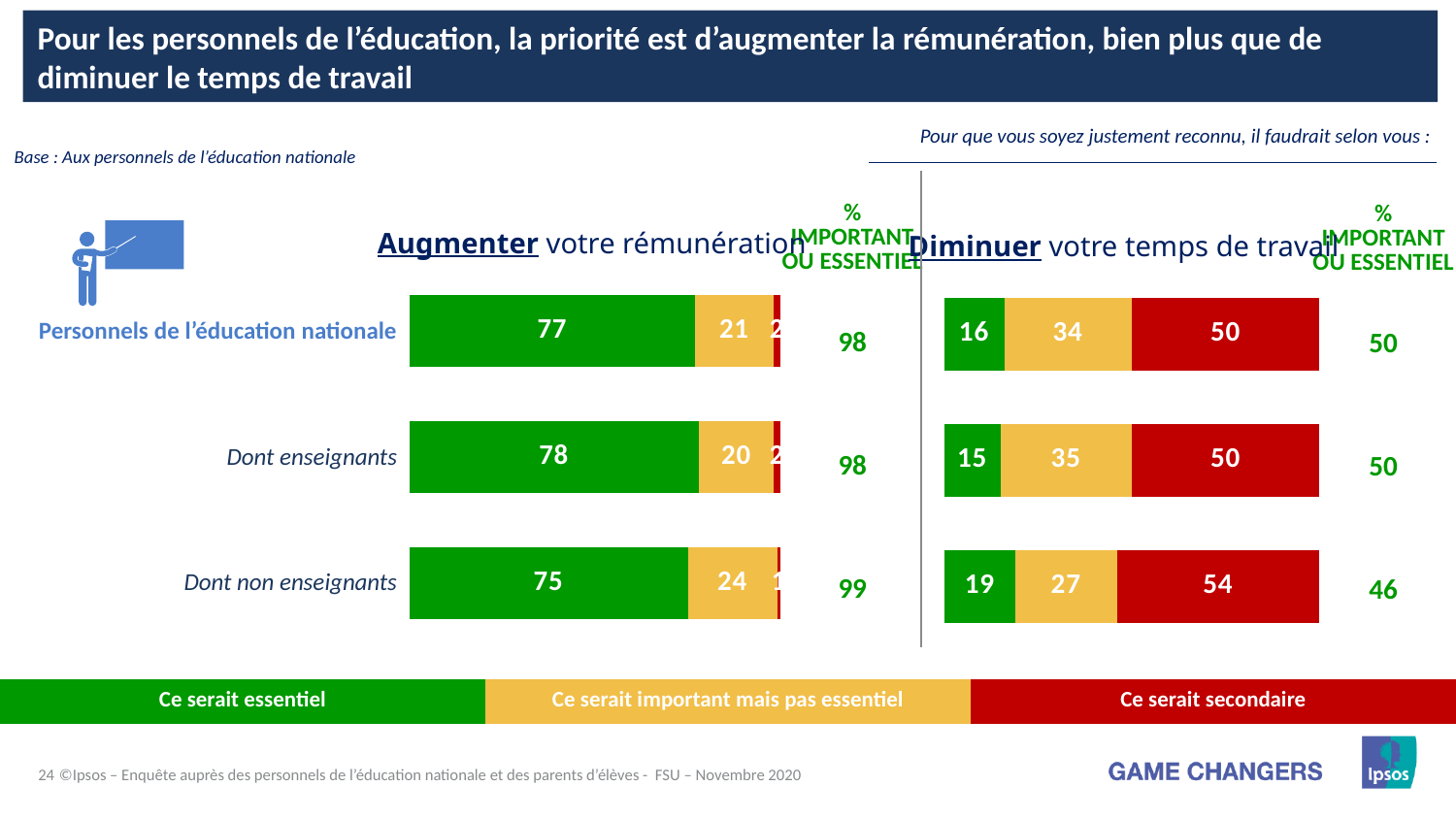
In the 'Augmenter votre rémunération' chart, what is the difference between the 'Ce serait essentiel' values for 'Dont enseignants' and 'Dont non enseignants'? 3 In the 'Diminuer votre temps de travail' chart, what is the value of 'Ce serait important mais pas essentiel' for 'Personnels de l'éducation nationale'? 34 In the 'Diminuer votre temps de travail' chart, which is larger for 'Dont non enseignants': 'Ce serait essentiel' or 'Ce serait important mais pas essentiel'? Ce serait important mais pas essentiel What type of chart is used for 'Diminuer votre temps de travail'? Stacked bar chart In the 'Diminuer votre temps de travail' chart, which category has the lowest 'Ce serait important mais pas essentiel' value? Dont non enseignants In the 'Augmenter votre rémunération' chart, which category has the highest 'Ce serait essentiel' value? Dont enseignants In the 'Augmenter votre rémunération' chart, what is the value of 'Ce serait essentiel' for 'Dont enseignants'? 78 In the 'Diminuer votre temps de travail' chart, what is the '% IMPORTANT OU ESSENTIEL' value for 'Dont non enseignants'? 46 In the 'Diminuer votre temps de travail' chart, what is the value of 'Ce serait secondaire' for 'Dont non enseignants'? 54 How many categories are shown in the 'Augmenter votre rémunération' chart? 3 How many series does the legend at the bottom of the slide list? 3 Which colour represents 'Ce serait secondaire' in the charts? Red